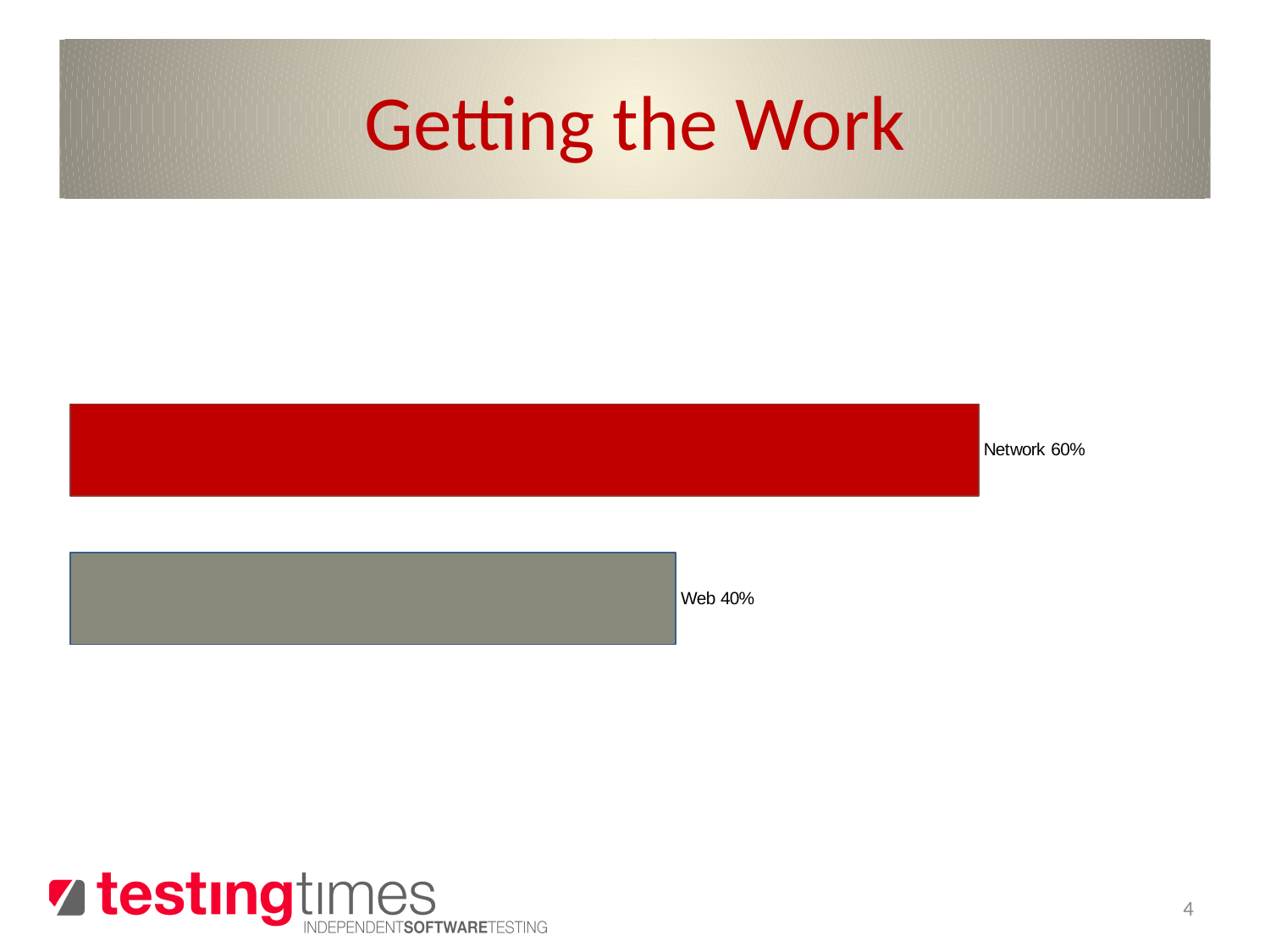
What is the value for Network? 60% What kind of chart is shown on the slide? Bar chart Which is larger, Network or Web? Network What is the total of the Network and Web values? 100% Which category has the highest value? Network How many categories are shown in the chart? 2 What is the value for Web? 40% What is the difference between the Network and Web values? 20% What is the title of the slide containing the chart? Getting the Work Which category has the lowest value? Web What colour is the Network bar? Red